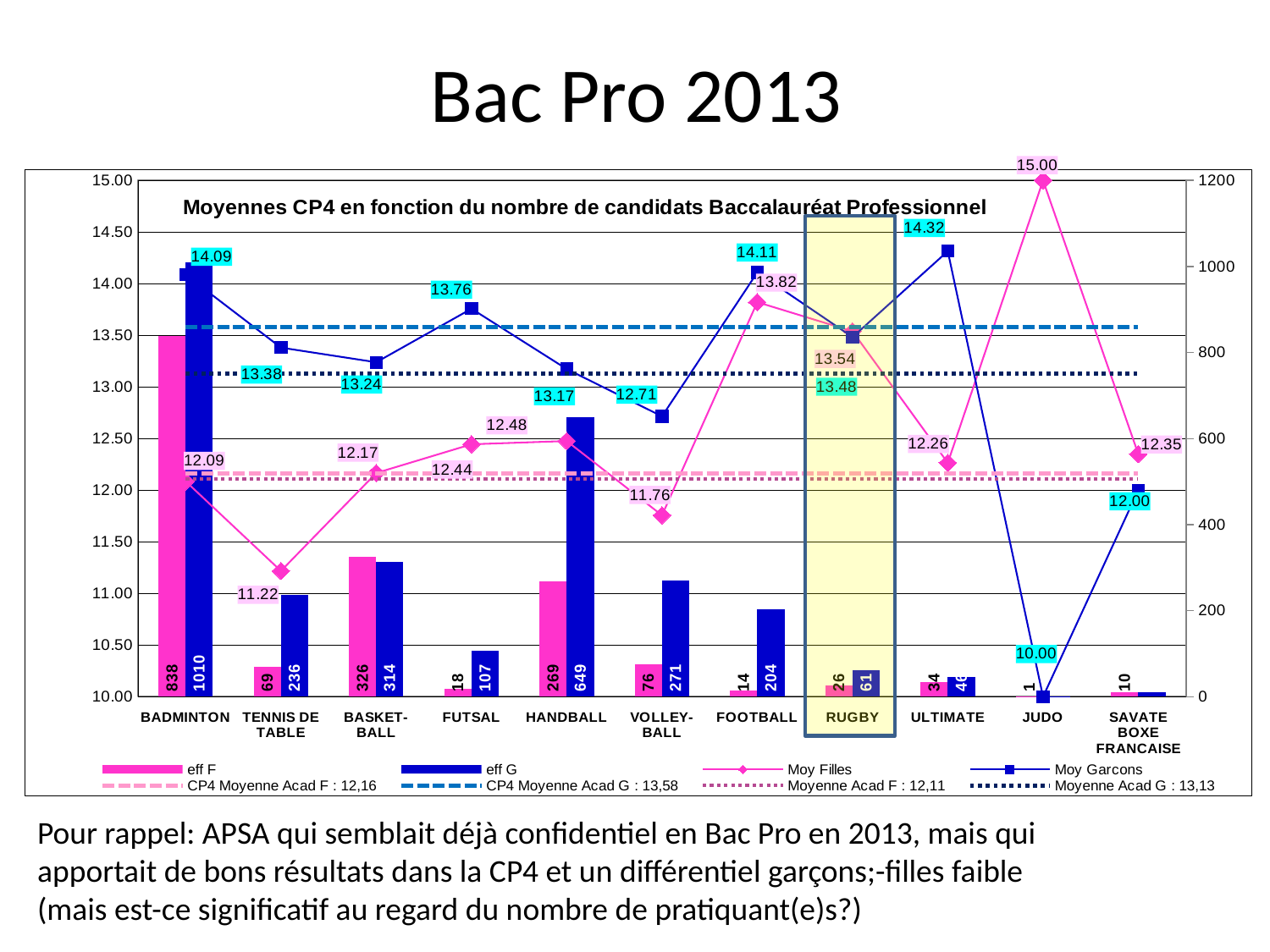
What is the difference between the Moy Garcons and Moy Filles values for FOOTBALL? 0.29 What is the eff G value for HANDBALL? 649 What is the difference between eff G and eff F for BADMINTON? 172 What is the Moy Garcons value for ULTIMATE? 14.32 Which category has the lowest Moy Garcons value? JUDO For HANDBALL, which is larger: eff F or eff G? eff G How many categories are shown on the x axis? 11 Which category has the highest eff G value? BADMINTON Which category has the lowest Moy Filles value? TENNIS DE TABLE How many series does the legend list? 8 What is the Moy Filles value for JUDO? 15.00 What is the eff F value for BADMINTON? 838